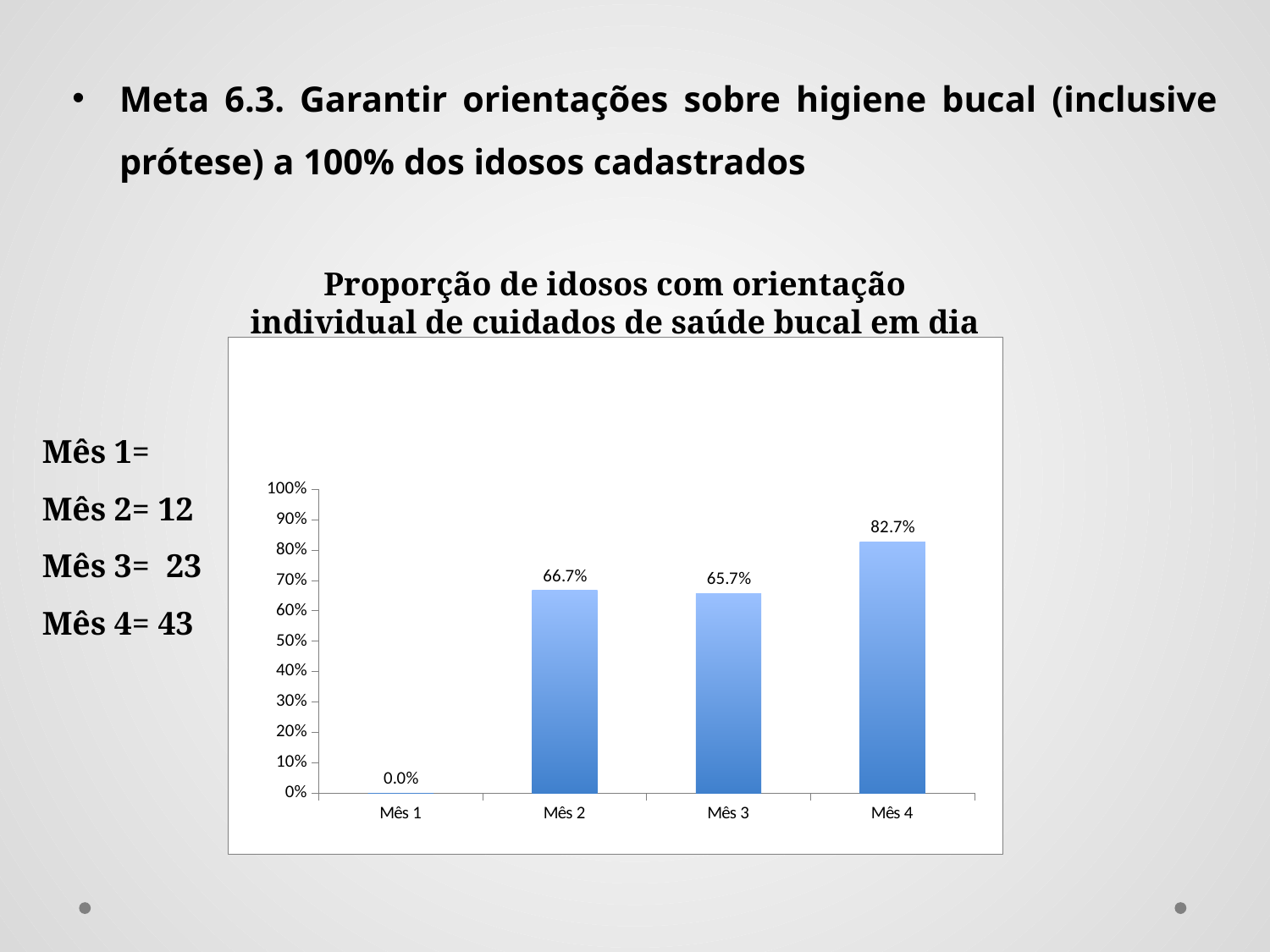
Is the value for Mês 4 greater or less than 80%? greater What is the difference between the values for Mês 4 and Mês 3? 17.0% What kind of chart is shown? Bar chart Which month has the lowest value? Mês 1 What is the value for Mês 3? 65.7% How many months are shown on the x axis? 4 Which month has the highest value? Mês 4 What is the value for Mês 2? 66.7% What is the difference between the values for Mês 2 and Mês 3? 1.0% Which is larger, the value for Mês 2 or the value for Mês 4? Mês 4 What is the value for Mês 4? 82.7% What is the value for Mês 1? 0.0%